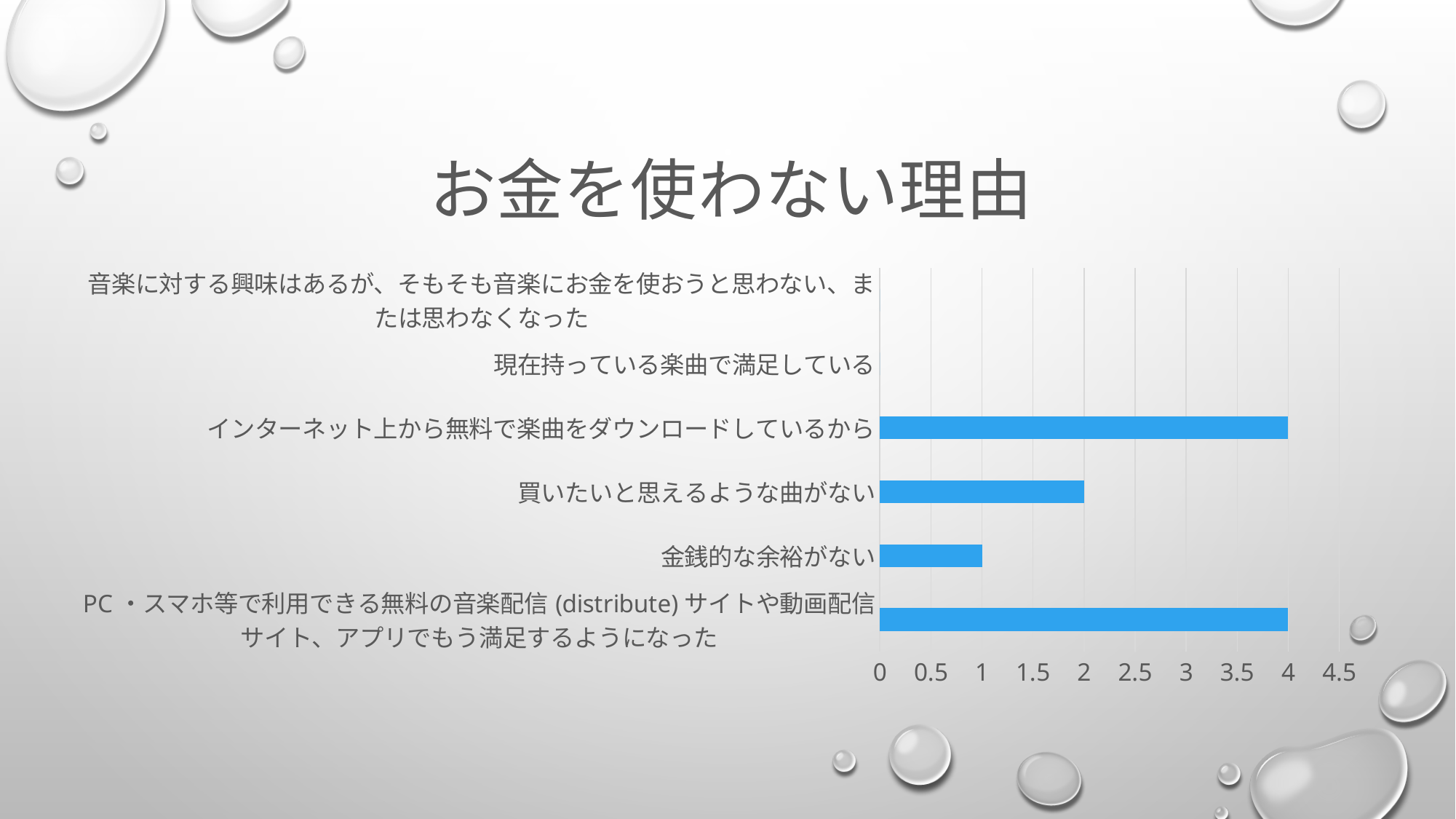
What is the value for 「インターネット上から無料で楽曲をダウンロードしているから」? 4 How many categories are listed on the chart? 6 What is the value for 「PC・スマホ等で利用できる無料の音楽配信 (distribute) サイトや動画配信サイト、アプリでもう満足するようになった」? 4 Which has a larger value: 「PC・スマホ等で利用できる無料の音楽配信 (distribute) サイトや動画配信サイト、アプリでもう満足するようになった」 or 「買いたいと思えるような曲がない」? PC・スマホ等で利用できる無料の音楽配信 (distribute) サイトや動画配信サイト、アプリでもう満足するようになった Is the value for 「金銭的な余裕がない」 greater or less than 2? less What is the title of the chart? お金を使わない理由 What is the value for 「買いたいと思えるような曲がない」? 2 What is the difference between the values for 「インターネット上から無料で楽曲をダウンロードしているから」 and 「買いたいと思えるような曲がない」? 2 Which has a larger value: 「買いたいと思えるような曲がない」 or 「金銭的な余裕がない」? 買いたいと思えるような曲がない What kind of chart is shown on the slide? bar chart What is the value for 「金銭的な余裕がない」? 1 What is the difference between the values for 「買いたいと思えるような曲がない」 and 「金銭的な余裕がない」? 1